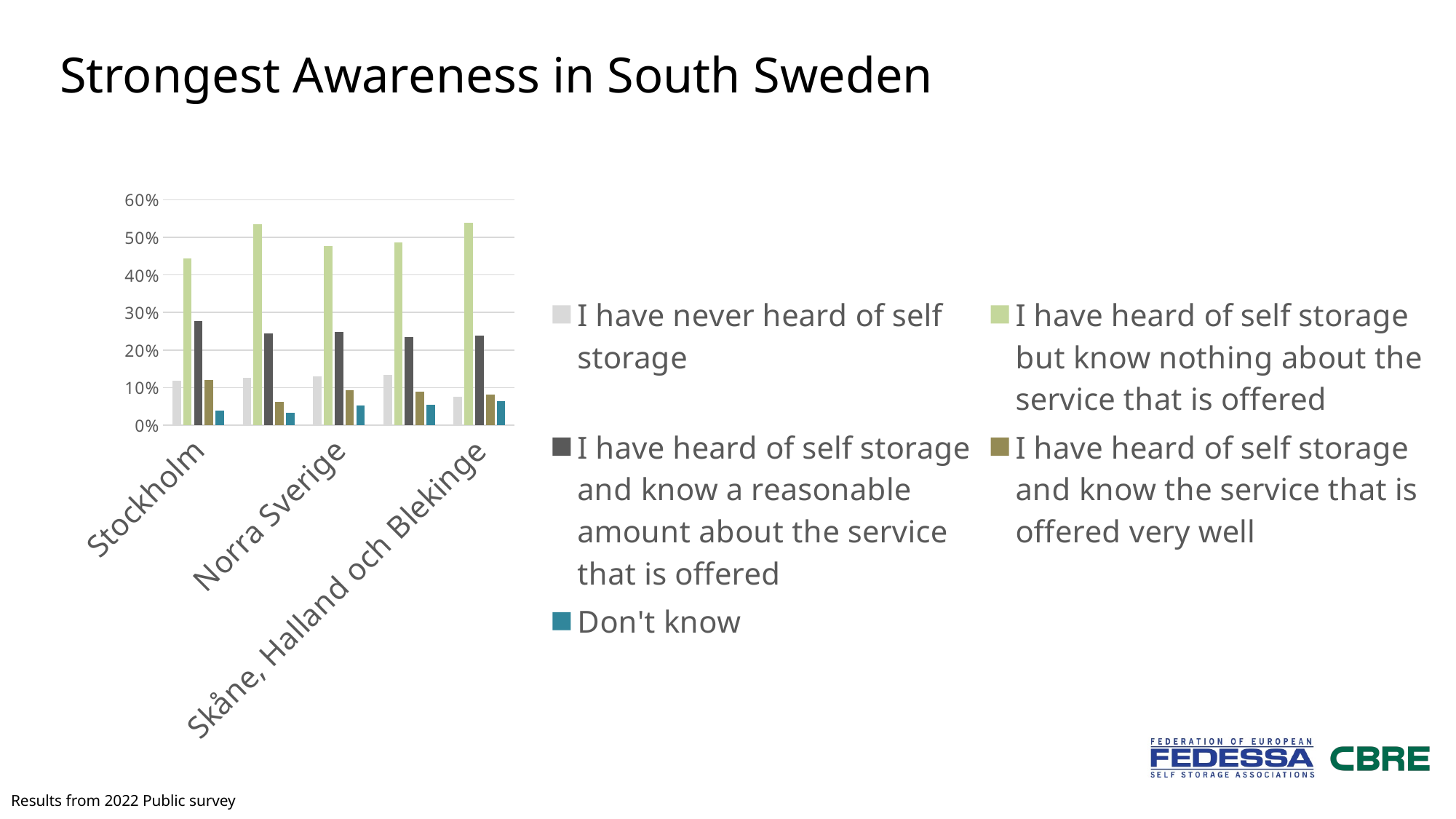
Which series has the lowest bar in the Stockholm group? Don't know Is the value for 'I have heard of self storage but know nothing about the service that is offered' in Stockholm greater or less than 40%? greater Is the value for 'I have heard of self storage but know nothing about the service that is offered' in Skåne, Halland och Blekinge greater or less than 50%? greater What is the title of the slide? Strongest Awareness in South Sweden Is the value for 'Don't know' in Stockholm greater or less than 10%? less Which series has the tallest bar in every group? I have heard of self storage but know nothing about the service that is offered How many groups of bars are plotted on the chart? 5 How many series does the legend list? 5 What colour represents the 'Don't know' series in the legend? teal blue In Stockholm, which is larger: 'I have never heard of self storage' or 'I have heard of self storage and know a reasonable amount about the service that is offered'? I have heard of self storage and know a reasonable amount about the service that is offered What kind of chart is shown on the slide? bar chart